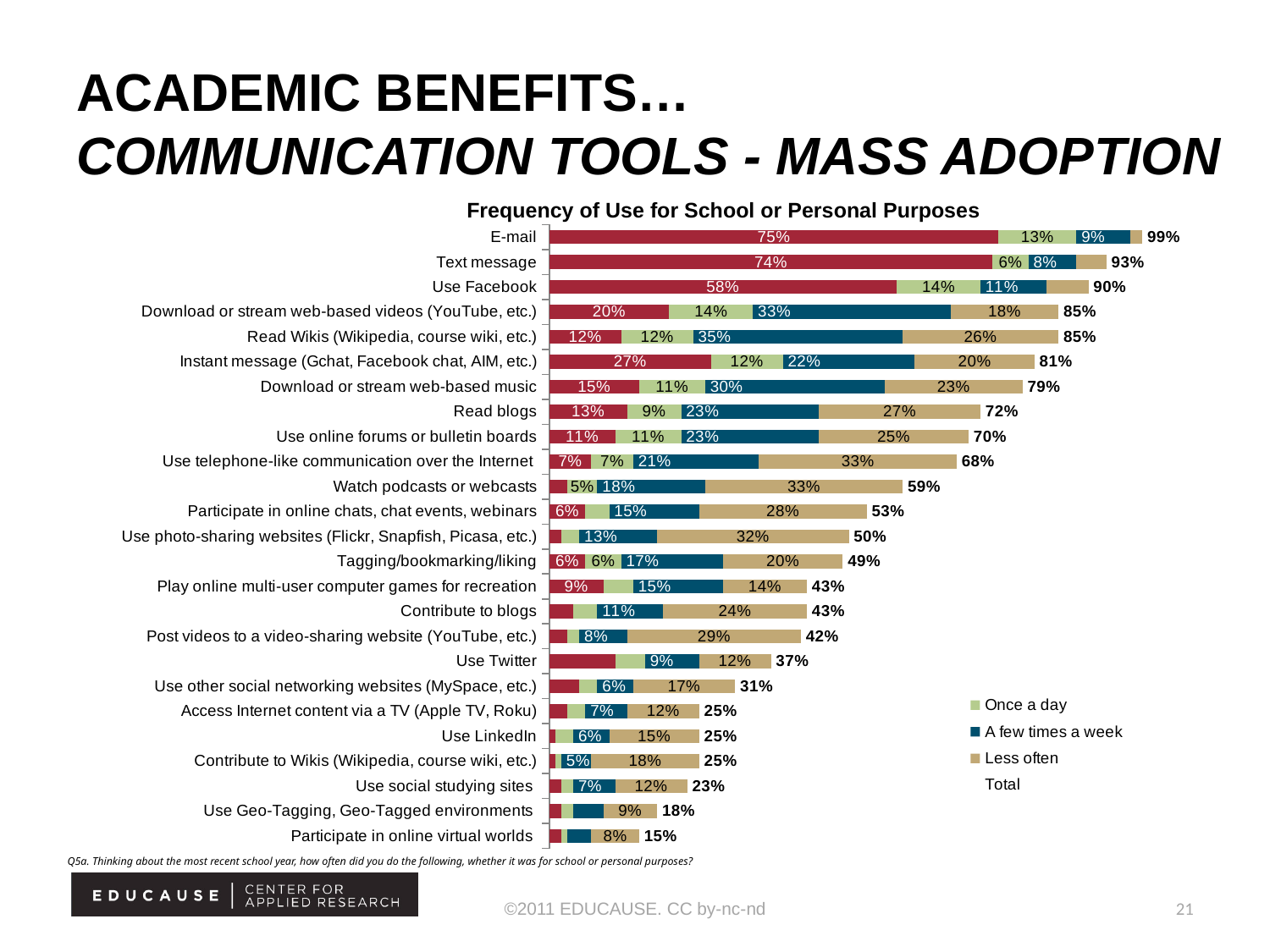
What is the Total value for E-mail? 99% What is the title of the chart? Frequency of Use for School or Personal Purposes Which has a larger Total value, Text message or Use Facebook? Text message How many activities (categories) are listed in the chart? 25 What is the 'A few times a week' value for Download or stream web-based videos (YouTube, etc.)? 33% What is the 'Less often' value for Read blogs? 27% What kind of chart is shown on the slide? Stacked bar chart What is the 'Once a day' value for Use Facebook? 14% What is the difference between the Total values for E-mail and Text message? 6% Which activity has the highest Total value? E-mail What is the Total value for Use Twitter? 37% Which activity has the lowest Total value? Participate in online virtual worlds